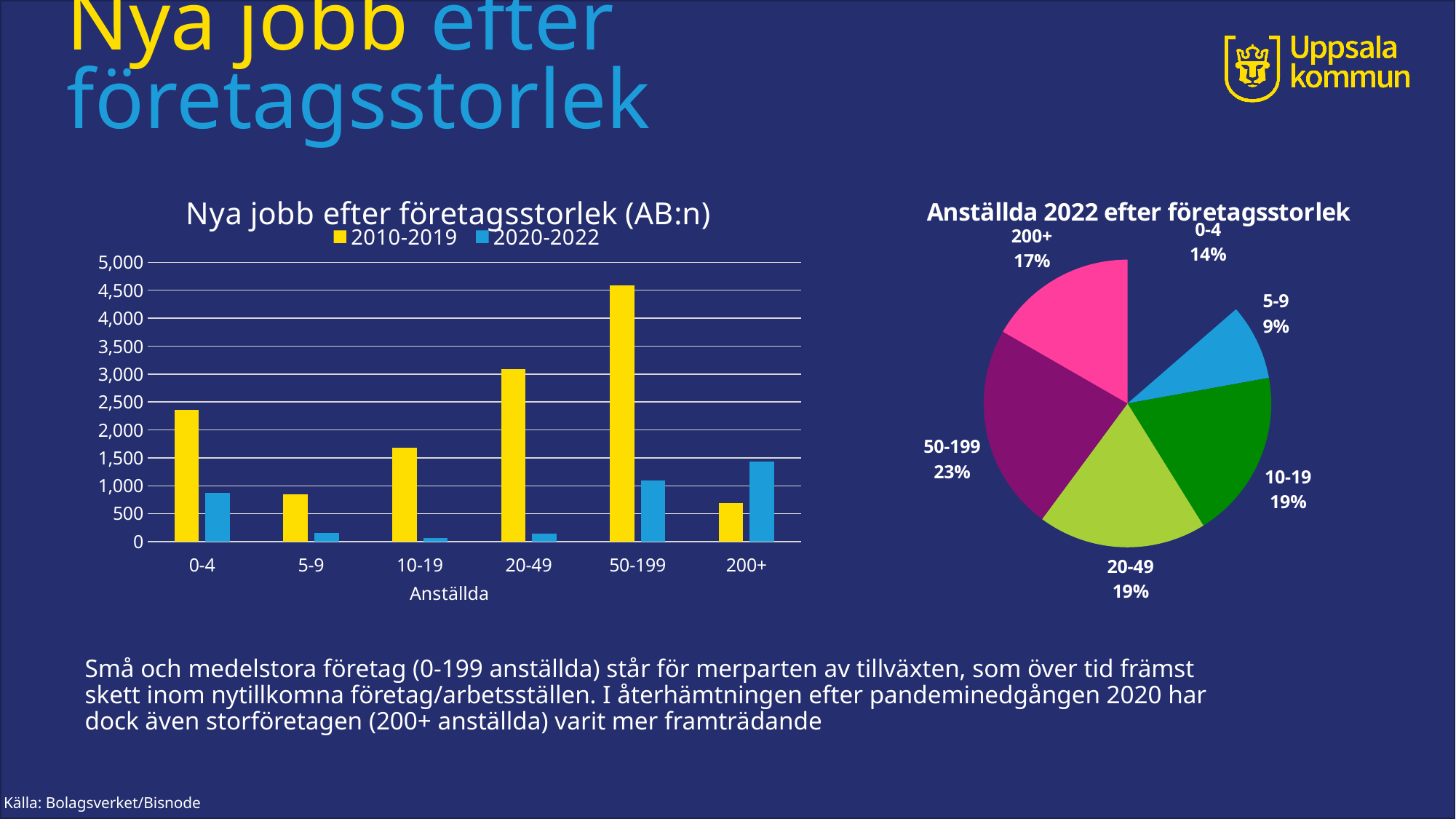
In the right pie chart 'Anställda 2022 efter företagsstorlek', what share does the 50-199 slice have? 23% What kind of chart is the left chart titled 'Nya jobb efter företagsstorlek (AB:n)'? bar chart In the left chart 'Nya jobb efter företagsstorlek (AB:n)', which category has the highest value for 2020-2022? 200+ In the left chart 'Nya jobb efter företagsstorlek (AB:n)', how many company-size categories are shown on the x axis? 6 In the right pie chart 'Anställda 2022 efter företagsstorlek', which category has the smallest share? 5-9 In the left chart 'Nya jobb efter företagsstorlek (AB:n)', which category has the highest value for 2010-2019? 50-199 In the left chart 'Nya jobb efter företagsstorlek (AB:n)', for the 200+ category, which series has the larger value: 2010-2019 or 2020-2022? 2020-2022 In the left chart 'Nya jobb efter företagsstorlek (AB:n)', is the 2020-2022 value for 0-4 greater or less than 1,000? less In the right pie chart 'Anställda 2022 efter företagsstorlek', how many slices are there? 6 In the left chart 'Nya jobb efter företagsstorlek (AB:n)', is the 2010-2019 value for 50-199 greater or less than 4,000? greater In the right pie chart 'Anställda 2022 efter företagsstorlek', how many percentage points larger is the 50-199 share than the 0-4 share? 9 In the left chart 'Nya jobb efter företagsstorlek (AB:n)', how many series does the legend list? 2